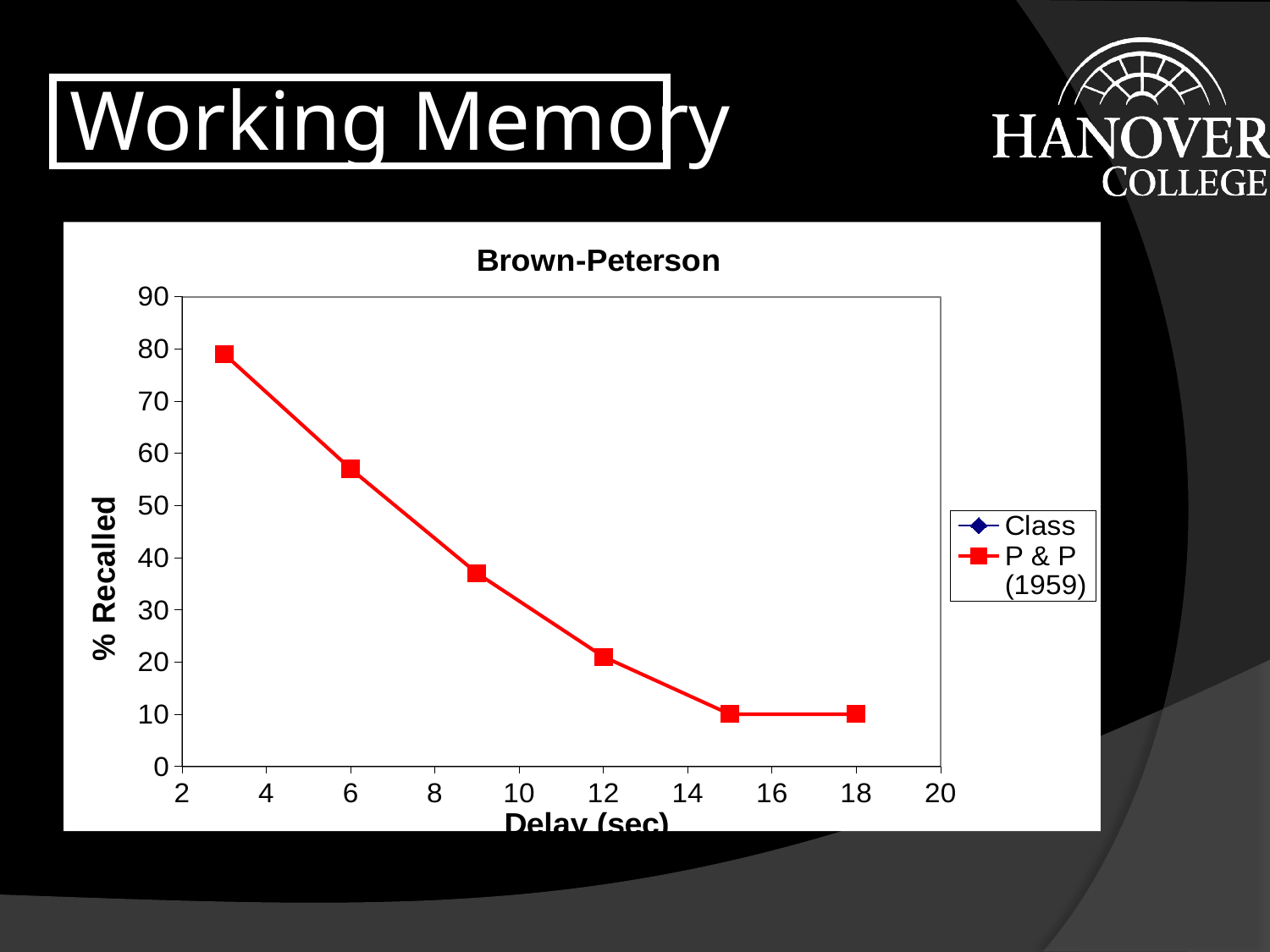
What is the % Recalled for the P & P (1959) series at a delay of 15 seconds? 10 What is the title of the chart? Brown-Peterson At which delay does the P & P (1959) series reach its highest % Recalled? 3 What is the % Recalled for the P & P (1959) series at a delay of 18 seconds? 10 How many data points are plotted for the P & P (1959) series? 6 Is the % Recalled for the P & P (1959) series at a delay of 3 seconds greater or less than 70? greater How many series does the legend list? 2 Is the % Recalled for the P & P (1959) series at a delay of 9 seconds greater or less than 40? less Is the % Recalled for the P & P (1959) series at a delay of 6 seconds greater or less than 50? greater Does the % Recalled for the P & P (1959) series rise or fall as the delay increases? fall What type of chart is shown on the slide? line chart